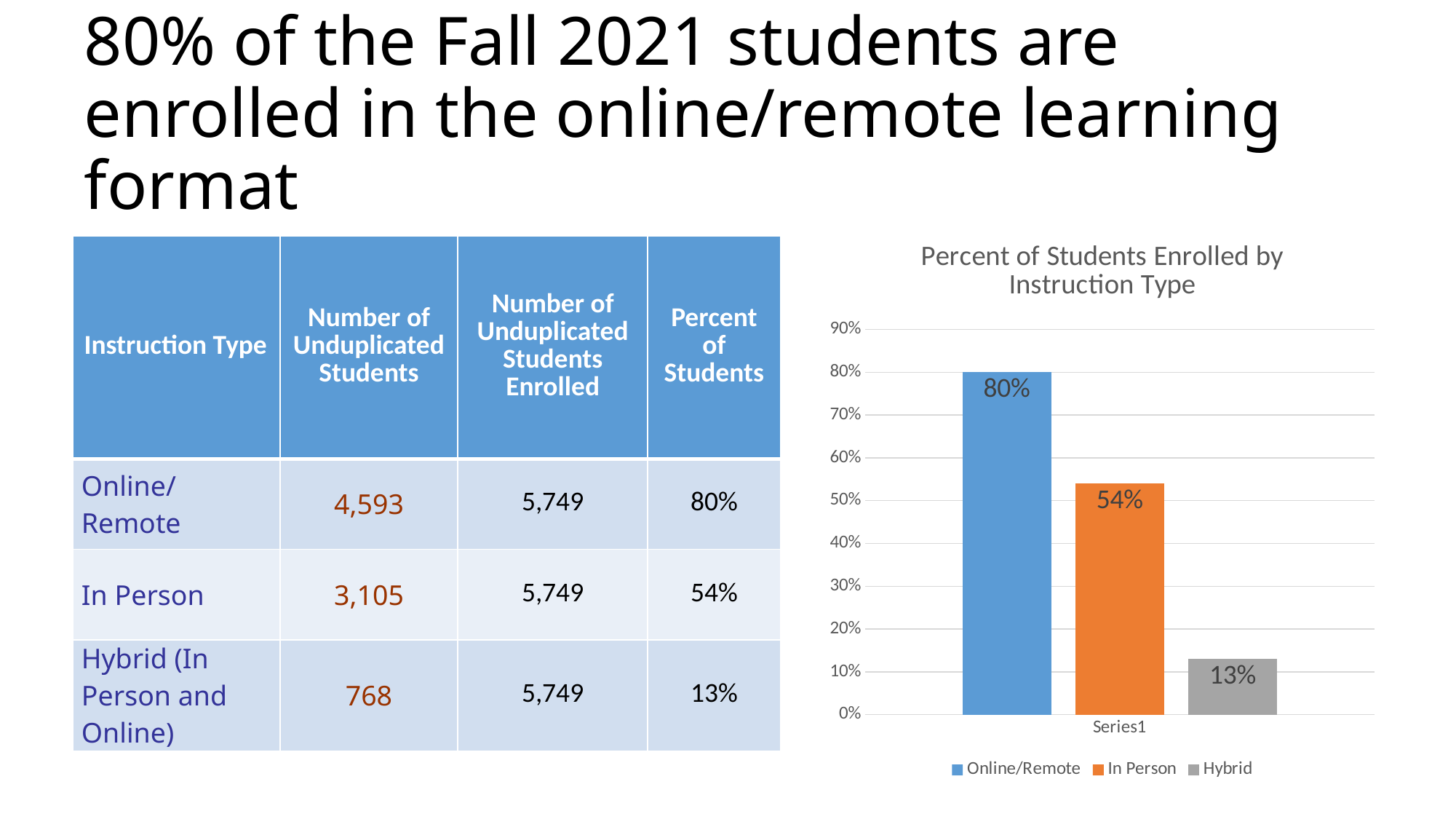
What kind of chart is shown on the slide? bar chart What is the title of the chart? Percent of Students Enrolled by Instruction Type Which is larger, the value for In Person or the value for Hybrid? In Person How many series does the legend list? 3 Is the value for In Person greater or less than 50%? greater Which series has the lowest value in the chart? Hybrid What is the value for In Person in the chart? 54% What is the difference between the In Person and Hybrid values? 41% What is the value for Online/Remote in the chart? 80% Which series has the highest value in the chart? Online/Remote What is the value for Hybrid in the chart? 13% What is the difference between the Online/Remote and In Person values? 26%